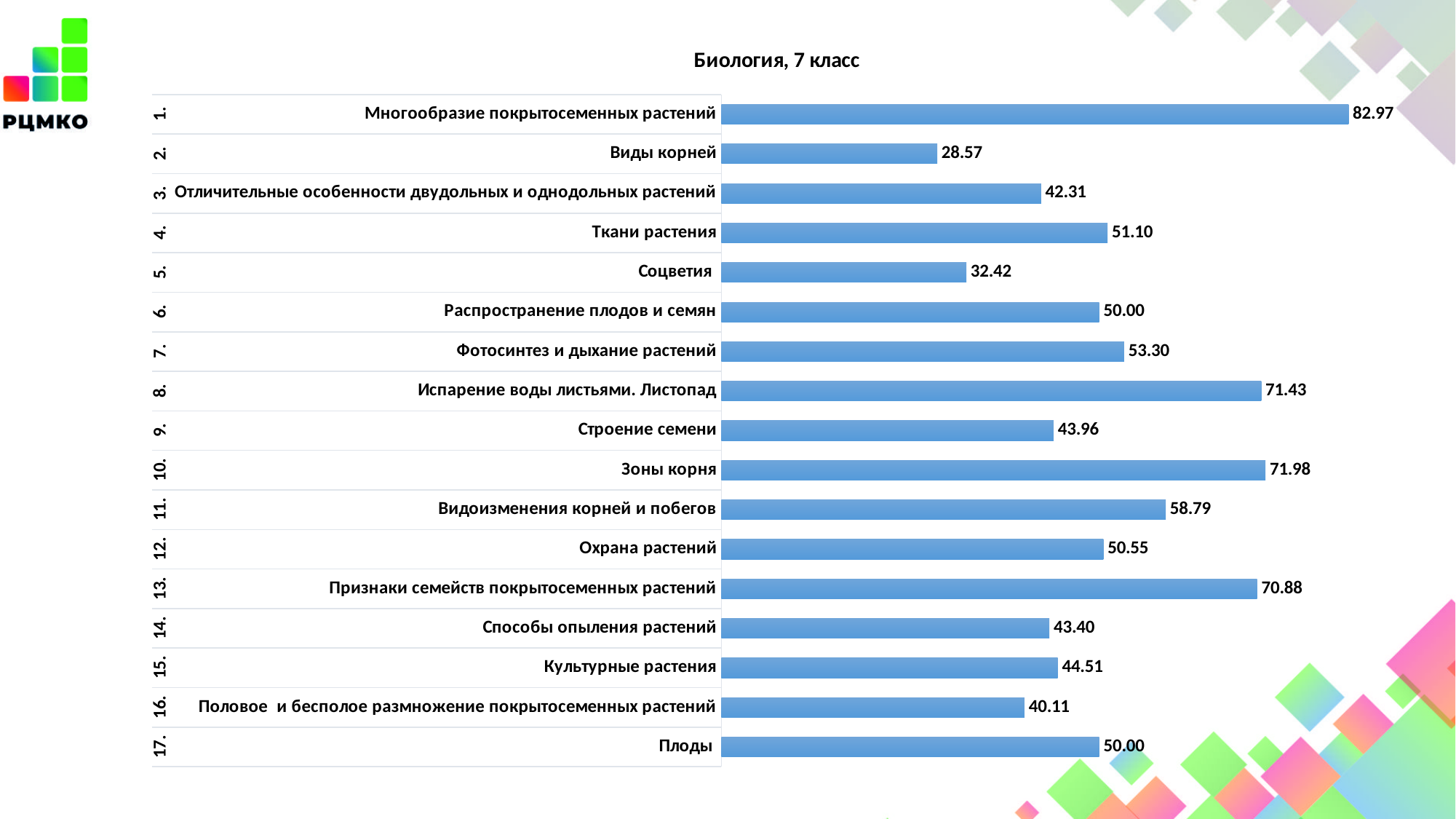
Which two categories share the value 50.00? Распространение плодов и семян; Плоды What is the difference between the values for "Многообразие покрытосеменных растений" and "Виды корней"? 54.40 What is the difference between the values for "Зоны корня" and "Соцветия"? 39.56 Which category has the highest value? Многообразие покрытосеменных растений What is the value for "Культурные растения"? 44.51 What is the value for "Испарение воды листьями. Листопад"? 71.43 How many categories are shown in the chart? 17 Which is larger: the value for "Ткани растения" or the value for "Фотосинтез и дыхание растений"? Фотосинтез и дыхание растений What is the value for "Виды корней"? 28.57 What kind of chart is shown on the slide? Bar chart What is the title of the chart? Биология, 7 класс Which category has the lowest value? Виды корней